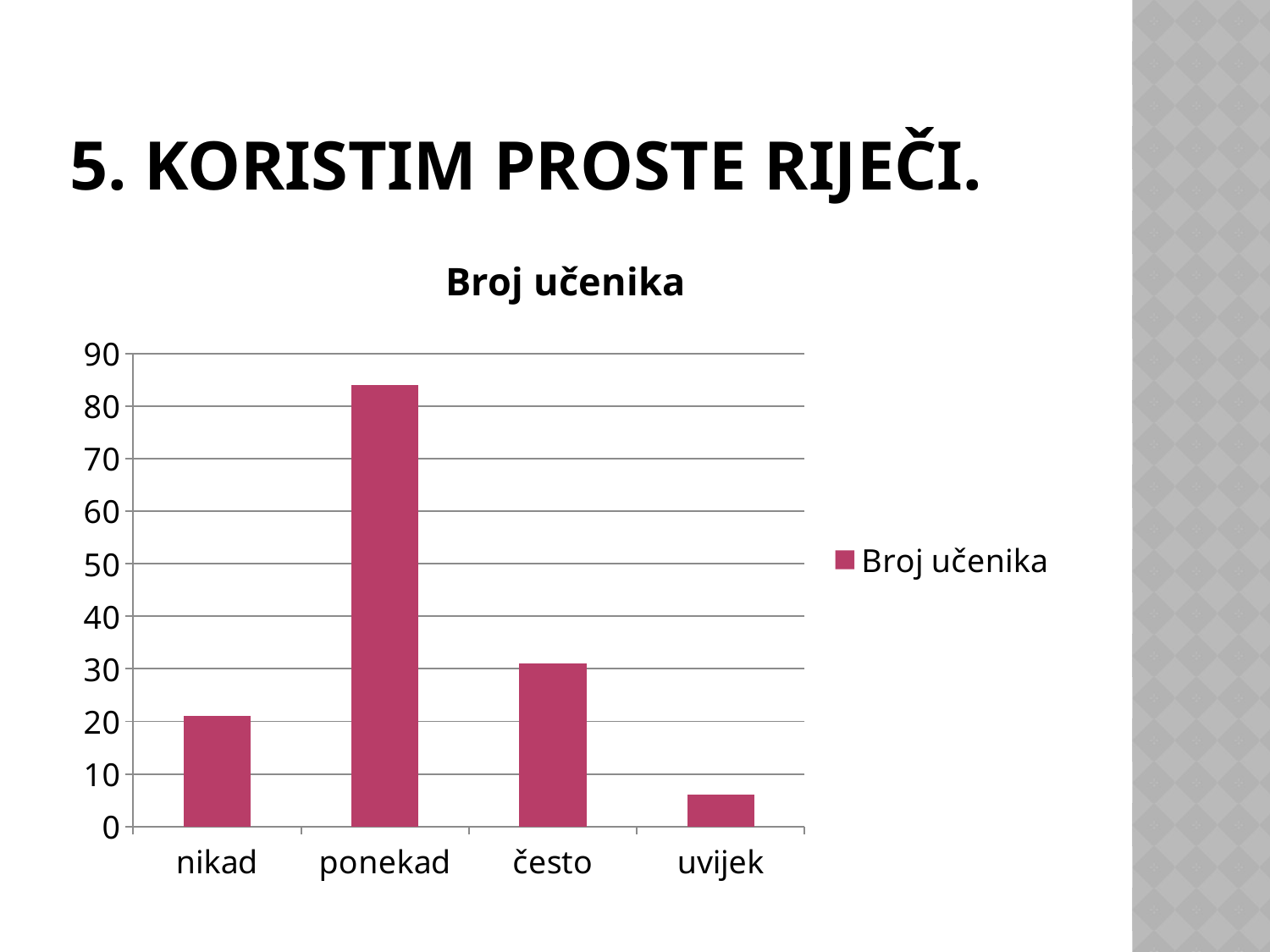
What is the name of the series shown in the legend? Broj učenika What kind of chart is shown on the slide? bar chart Which is larger, the value for nikad or the value for često? često Is the value for ponekad greater or less than 80? greater Which category has the highest value? ponekad Is the value for nikad greater or less than 30? less How many series does the legend list? 1 How many categories are shown on the x axis? 4 What is the title of the chart? Broj učenika Which category has the lowest value? uvijek Is the value for uvijek greater or less than 10? less